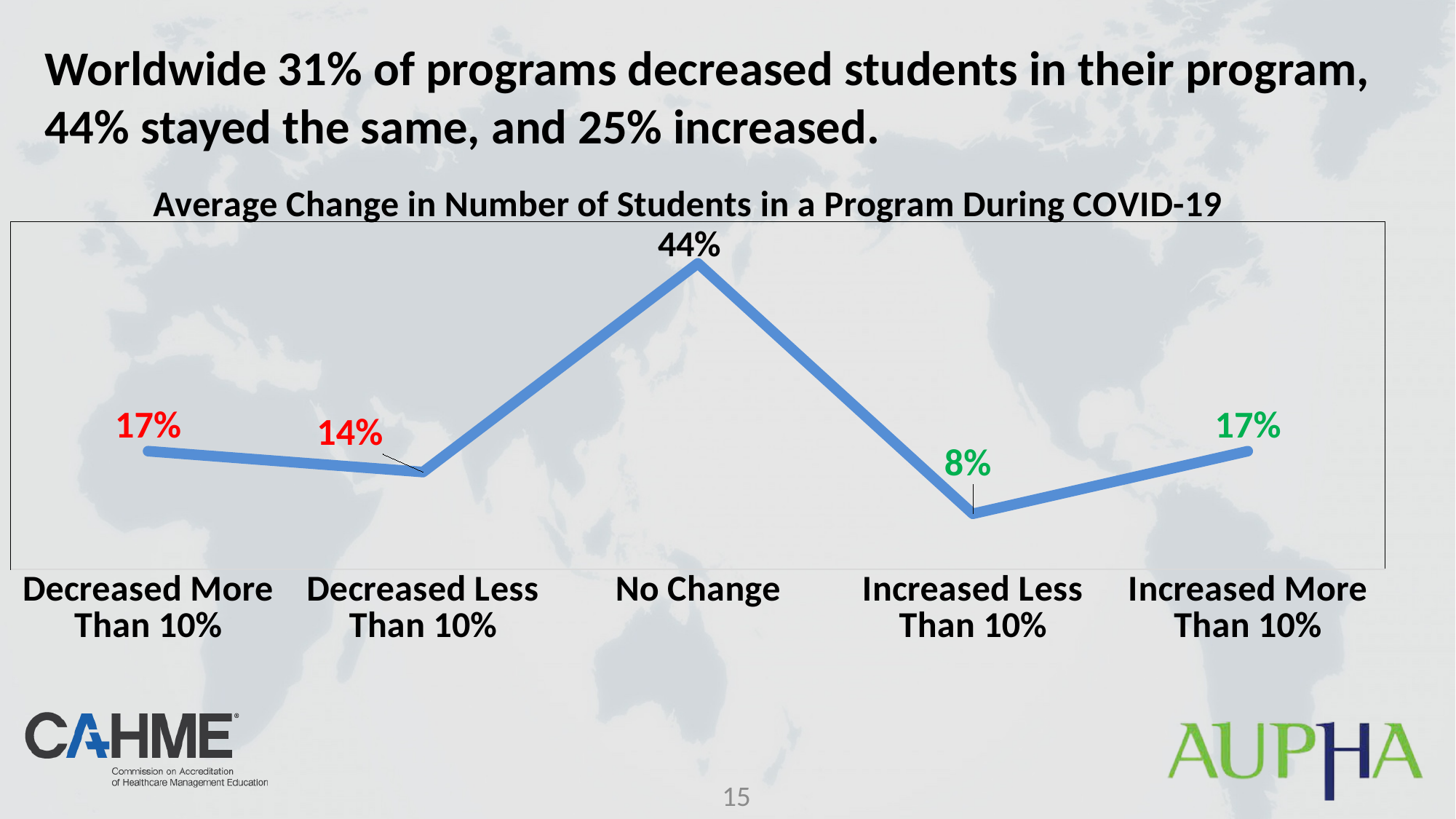
What is the value for Decreased Less Than 10%? 14% What is the value for No Change? 44% How many categories are plotted on the x axis? 5 What is the title of the chart? Average Change in Number of Students in a Program During COVID-19 What is the value for Decreased More Than 10%? 17% Which category has the lowest value? Increased Less Than 10% What is the difference between the values for Decreased More Than 10% and Decreased Less Than 10%? 3% Which is larger, the value for Decreased Less Than 10% or the value for Increased Less Than 10%? Decreased Less Than 10% What kind of chart is shown on the slide? Line chart What is the value for Increased Less Than 10%? 8% What is the difference between the values for No Change and Increased Less Than 10%? 36% Which category has the highest value? No Change